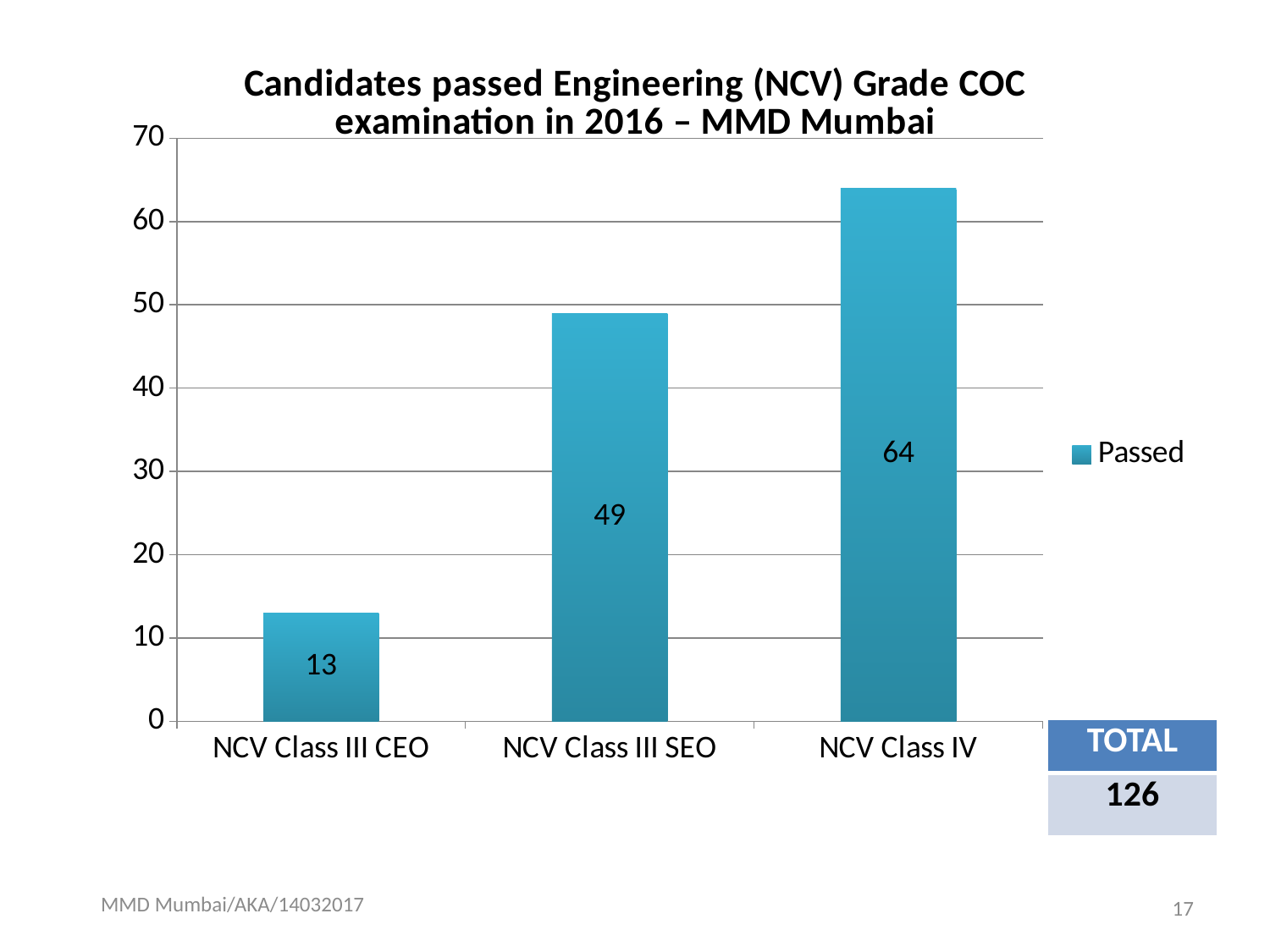
How many candidates passed for NCV Class IV? 64 Which category has the lowest number of candidates passed? NCV Class III CEO What is the difference between the number passed for NCV Class IV and NCV Class III SEO? 15 How many series does the legend list? 1 How many candidates passed for NCV Class III CEO? 13 What is the total number of candidates passed shown in the TOTAL box next to the chart? 126 What kind of chart is shown on the slide? Bar chart How many categories are shown on the x axis? 3 Which category has the highest number of candidates passed? NCV Class IV How many candidates passed for NCV Class III SEO? 49 Which has more candidates passed, NCV Class III CEO or NCV Class III SEO? NCV Class III SEO What is the difference between the number passed for NCV Class III SEO and NCV Class III CEO? 36